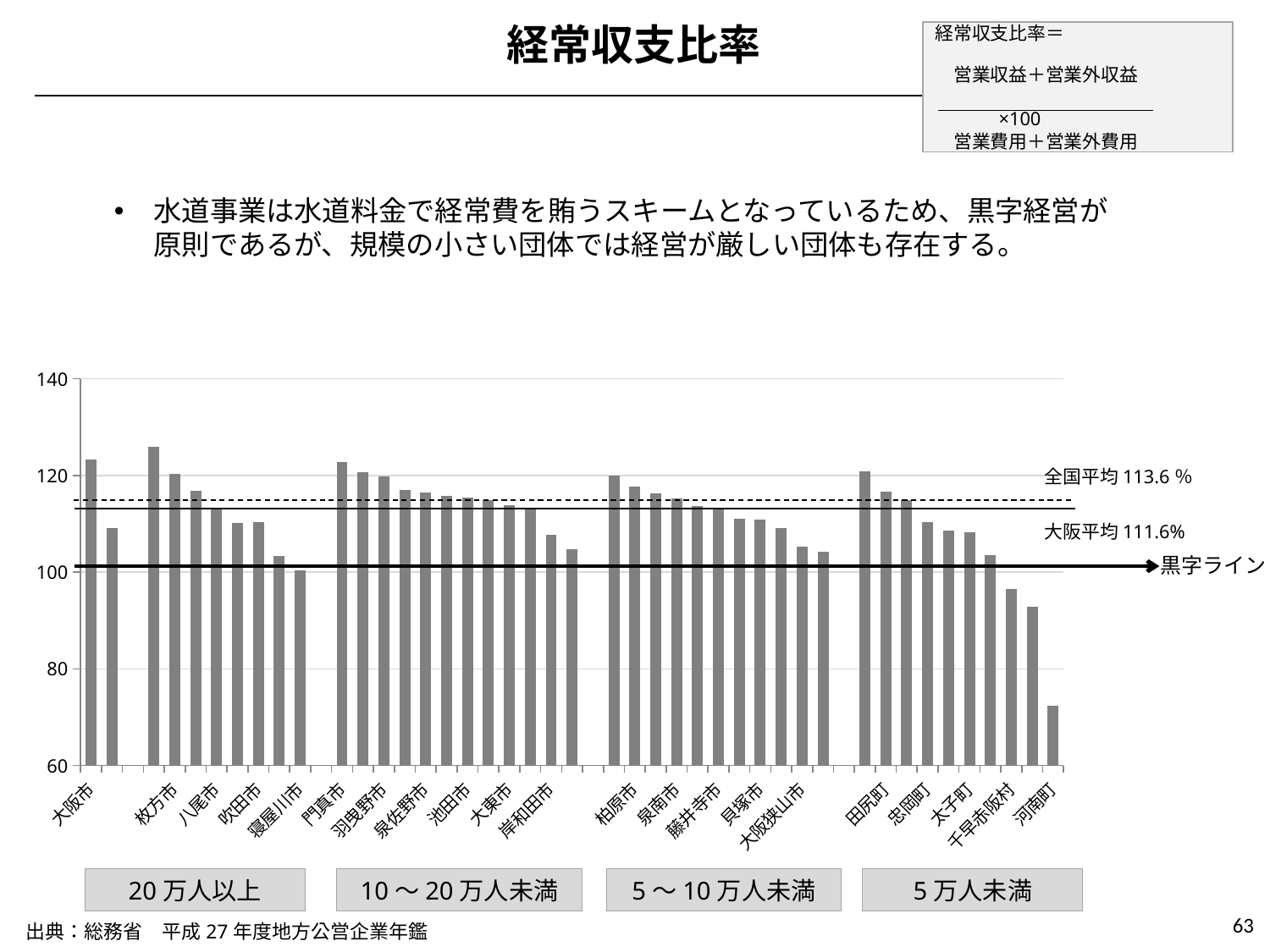
Which of the two average reference lines is higher, 全国平均 or 大阪平均? 全国平均 Is the value for 大阪市 greater or less than 120? greater What is the title of the slide containing the chart? 経常収支比率 What kind of chart is shown on the slide? bar chart What value does the 大阪平均 reference line on the chart indicate? 111.6% Which category has the lowest bar in the chart? 河南町 Do the bars in the 5万人未満 group generally rise or fall from left to right? fall How many population-size groups are the bars divided into along the x axis? 4 Is the value for 河南町 greater or less than 80? less What value does the 全国平均 reference line on the chart indicate? 113.6% Which has the larger value, 大阪市 or 河南町? 大阪市